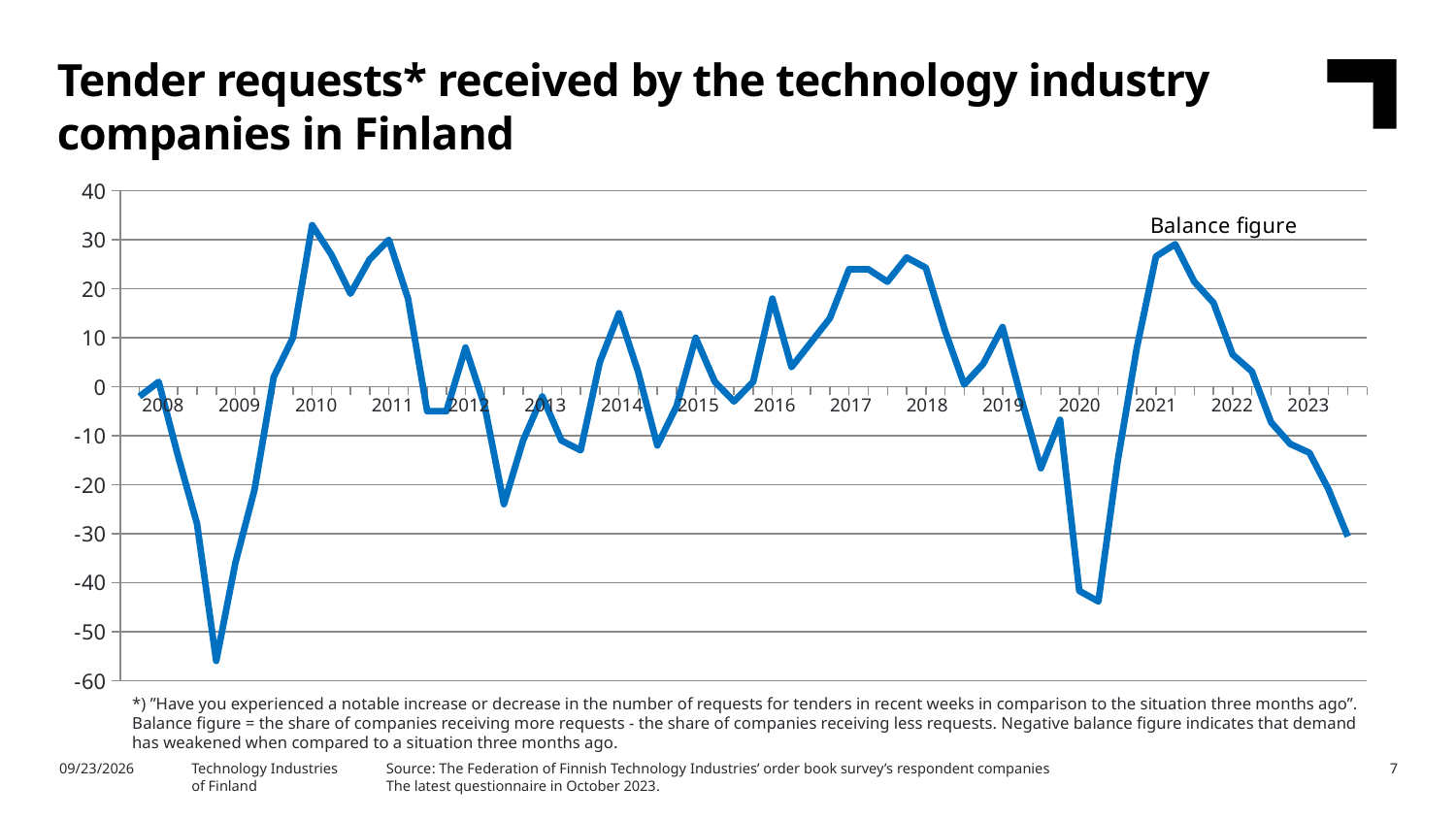
What kind of chart is shown on the slide? line chart What is the label shown for the plotted series? Balance figure What is the title of the chart on the slide? Tender requests* received by the technology industry companies in Finland Is the value at the 2010 peak greater or less than 30? greater Is the value at the 2021 peak greater or less than 20? greater Is the value at the last point of the line (late 2023) greater or less than -20? less Does the line rise or fall from the 2021 peak to the end of 2023? fall Which is lower, the trough between 2008 and 2009 or the trough in 2020? the trough between 2008 and 2009 Does the line rise or fall from the 2020 trough to the 2021 peak? rise How many years are labelled on the x axis? 16